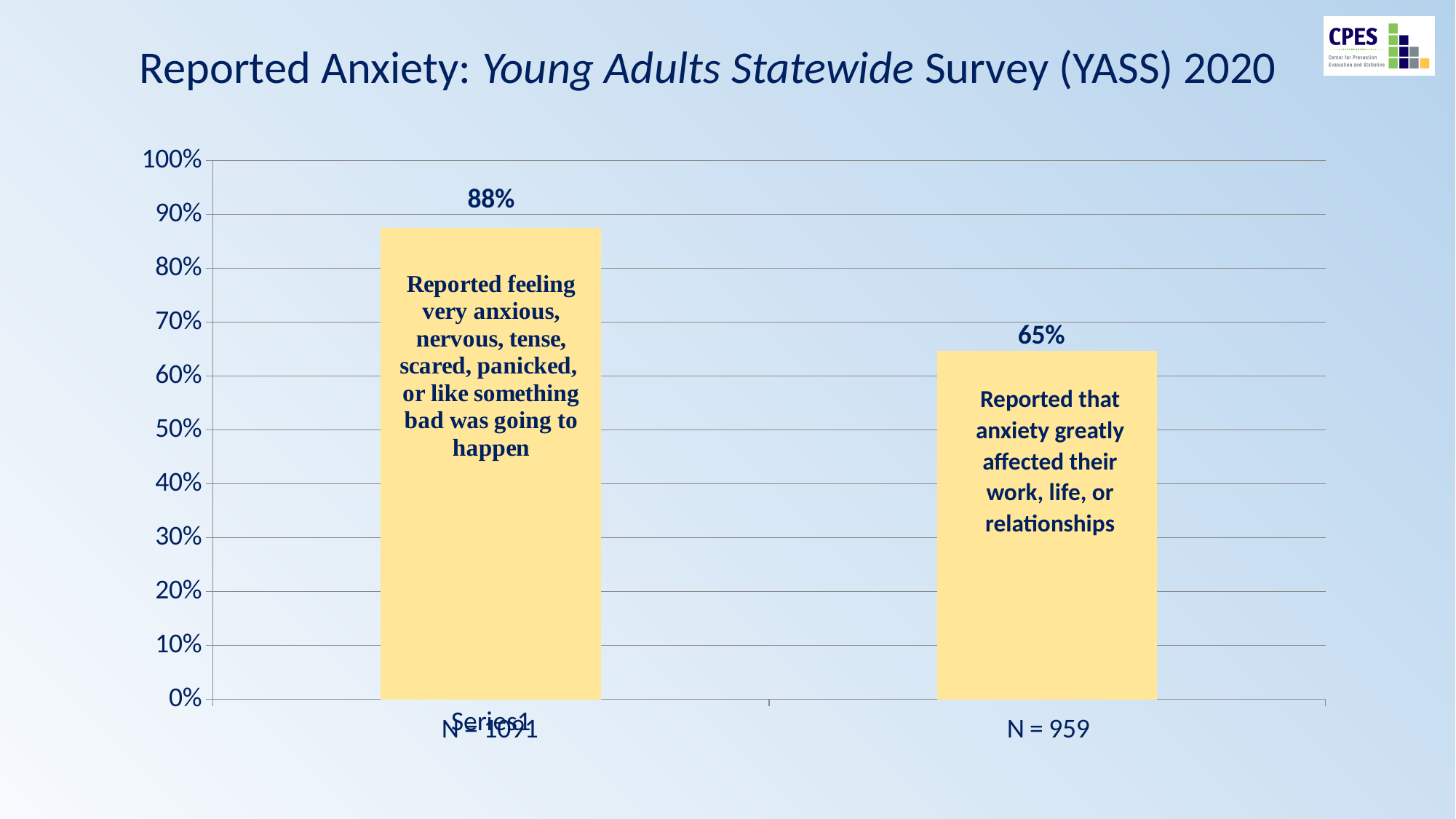
Is the value for the bar labelled 'Reported feeling very anxious...' greater or less than 80%? greater What percentage of respondents reported feeling very anxious, nervous, tense, scared, panicked, or like something bad was going to happen? 88% What percentage of respondents reported that anxiety greatly affected their work, life, or relationships? 65% How many bars are plotted on the chart? 2 Which bar shows the lower value? Reported that anxiety greatly affected their work, life, or relationships What is the sample size (N) shown under the bar for anxiety greatly affecting work, life, or relationships? N = 959 What is the maximum value shown on the vertical axis? 100% Which bar shows the higher value: reported feeling very anxious or reported that anxiety greatly affected their work, life, or relationships? Reported feeling very anxious Is the value for the bar labelled 'Reported that anxiety greatly affected their work, life, or relationships' greater or less than 70%? less What is the difference in percentage points between the two bars? 23 percentage points What type of chart is shown on the slide? Bar chart